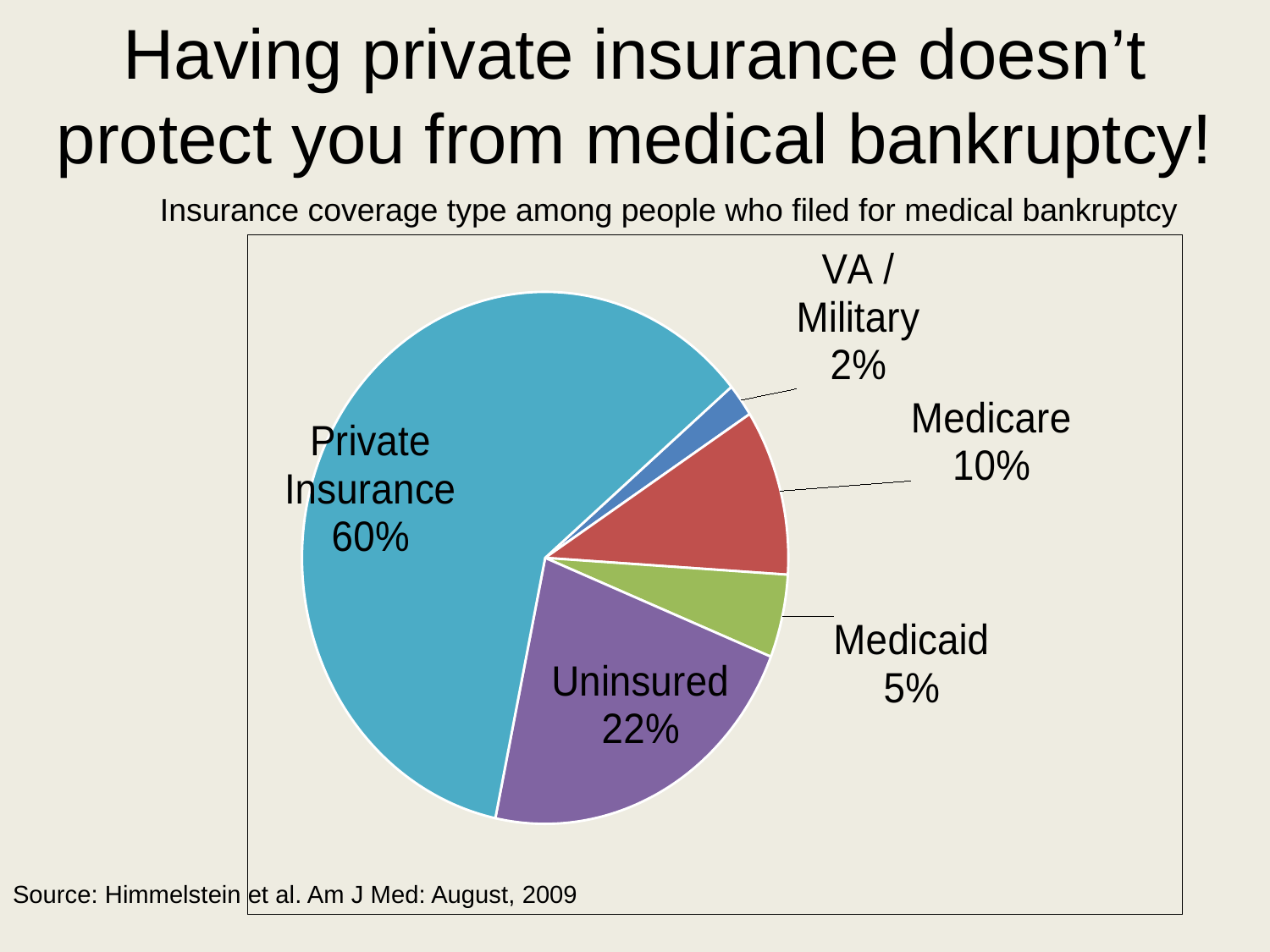
Which is larger, the Medicare slice or the Medicaid slice? Medicare What is the difference in percentage points between Private Insurance and Uninsured? 38 What is the value shown for VA / Military? 2% What is the value shown for Medicaid? 5% What is the value shown for Medicare? 10% Which coverage type has the smallest slice of the pie? VA / Military What share of people who filed for medical bankruptcy had Private Insurance? 60% How many slices does the pie chart have? 5 What kind of chart is shown on the slide? Pie chart What is the title printed directly above the pie chart? Insurance coverage type among people who filed for medical bankruptcy Which coverage type has the largest slice of the pie? Private Insurance What percentage of the pie is labelled Uninsured? 22%